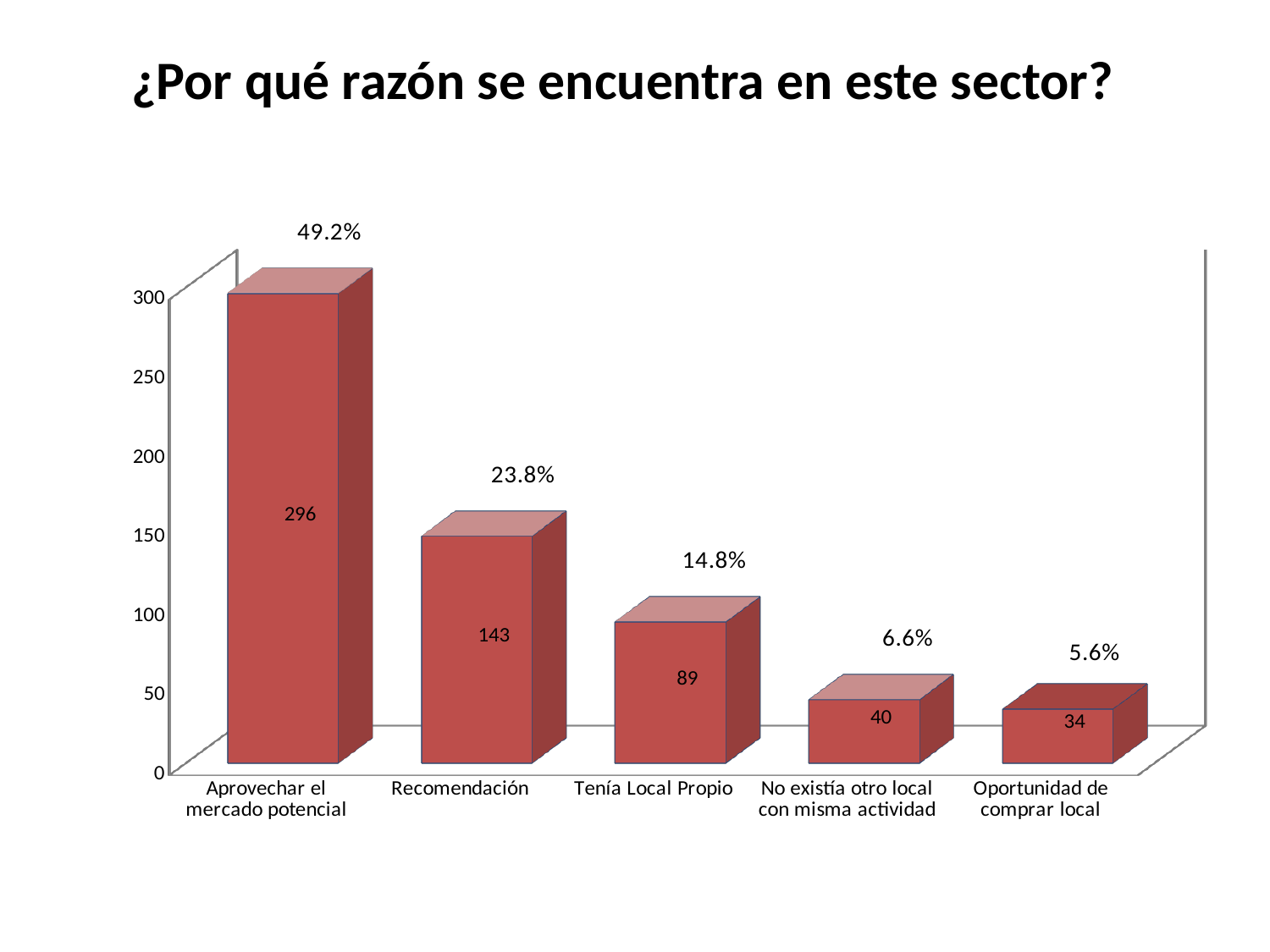
Which is larger, the value for Tenía Local Propio or the value for No existía otro local con misma actividad? Tenía Local Propio What kind of chart is shown on the slide? bar chart How many categories are shown on the chart? 5 Which category has the highest value? Aprovechar el mercado potencial What is the difference between the values for Aprovechar el mercado potencial and Recomendación? 153 What percentage is shown above the bar for Tenía Local Propio? 14.8% Is the value for Recomendación greater or less than 100? greater Do the values rise or fall from left to right along the x axis? fall What is the value for Recomendación? 143 Which category has the lowest value? Oportunidad de comprar local What is the value for Oportunidad de comprar local? 34 What is the title of the slide? ¿Por qué razón se encuentra en este sector?